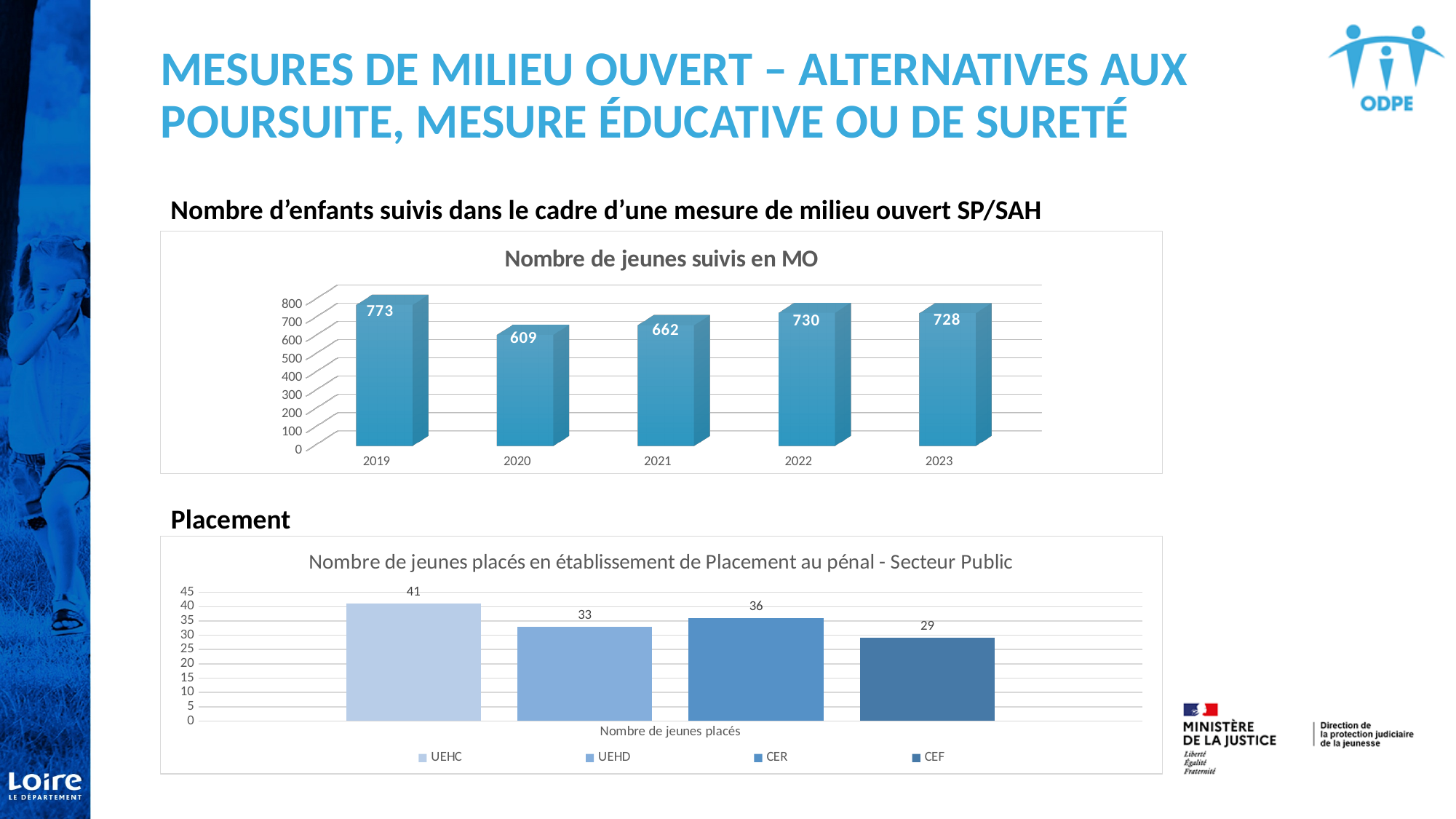
In the chart 'Nombre de jeunes placés en établissement de Placement au pénal - Secteur Public', what is the difference between the values for CER and CEF? 7 In the chart 'Nombre de jeunes suivis en MO', how many years are shown on the x axis? 5 In the chart 'Nombre de jeunes suivis en MO', which year has the lowest value? 2020 In the chart 'Nombre de jeunes suivis en MO', what is the value for 2019? 773 In the chart 'Nombre de jeunes suivis en MO', which year has the highest value? 2019 In the chart 'Nombre de jeunes placés en établissement de Placement au pénal - Secteur Public', what is the value for UEHD? 33 In the chart 'Nombre de jeunes suivis en MO', what is the difference between the values for 2019 and 2020? 164 In the chart 'Nombre de jeunes placés en établissement de Placement au pénal - Secteur Public', which category has the highest value? UEHC In the chart 'Nombre de jeunes suivis en MO', is the value for 2022 greater or less than the value for 2021? greater In the chart 'Nombre de jeunes placés en établissement de Placement au pénal - Secteur Public', how many series does the legend list? 4 In the chart 'Nombre de jeunes suivis en MO', what is the value for 2021? 662 In the chart 'Nombre de jeunes placés en établissement de Placement au pénal - Secteur Public', which category has the lowest value? CEF